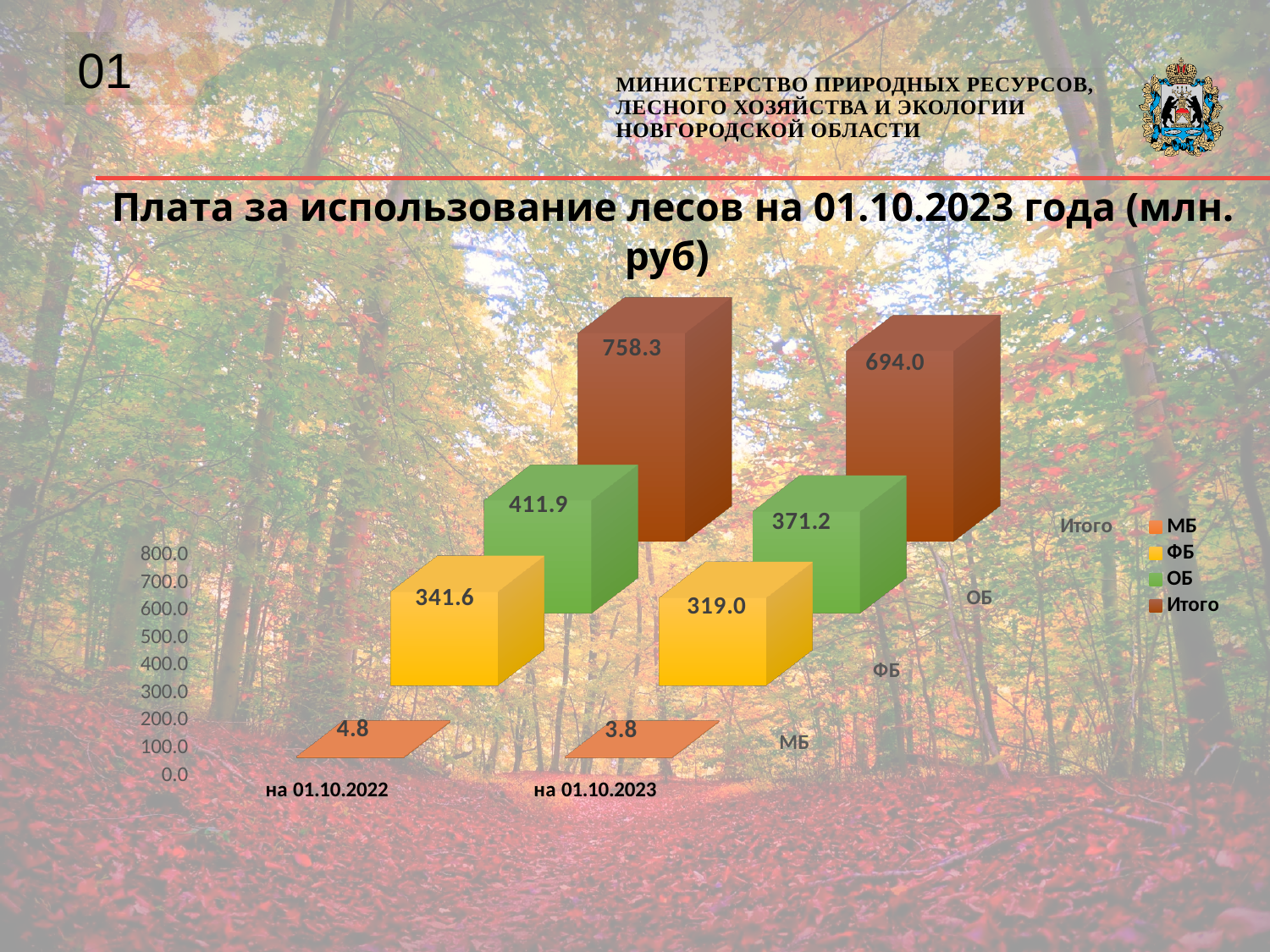
What is the value of ФБ for на 01.10.2022? 341.6 How many series does the legend list? 4 What is the value of Итого for на 01.10.2022? 758.3 Which is larger: ОБ for на 01.10.2022 or ОБ for на 01.10.2023? ОБ for на 01.10.2022 Which series has the highest value for на 01.10.2023? Итого What kind of chart is shown on the slide? Bar chart Does the ФБ value rise or fall from на 01.10.2022 to на 01.10.2023? Fall What is the value of ОБ for на 01.10.2023? 371.2 What is the value of МБ for на 01.10.2023? 3.8 How many categories are shown on the x axis? 2 Which series has the lowest value for на 01.10.2022? МБ What is the difference between the Итого values for на 01.10.2022 and на 01.10.2023? 64.3